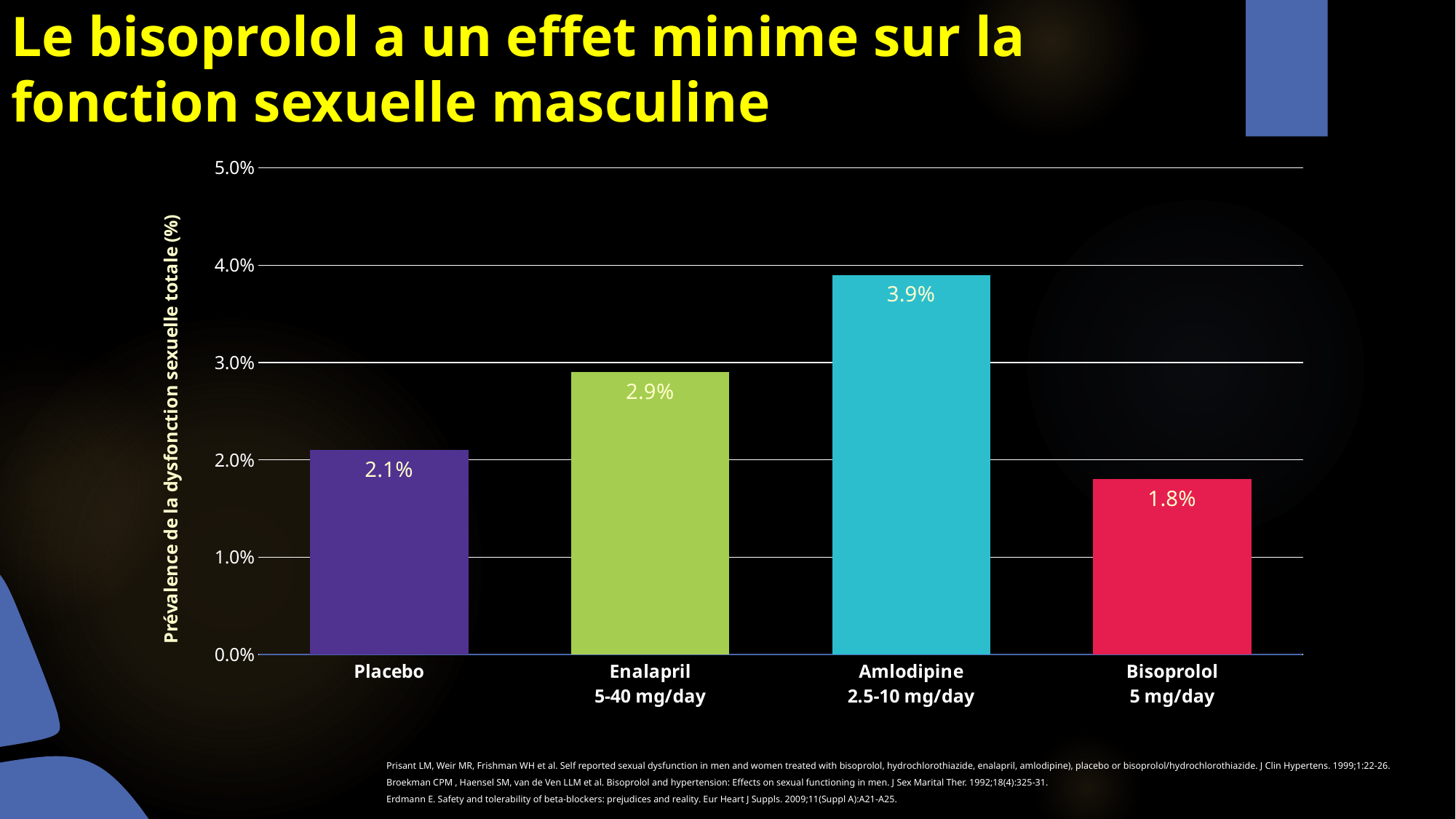
What is the difference between the values for Placebo and Bisoprolol? 0.3% Which is larger, the value for Enalapril or the value for Placebo? Enalapril What is the difference between the values for Amlodipine and Bisoprolol? 2.1% How many categories are shown on the x axis? 4 What is the value for Amlodipine 2.5-10 mg/day? 3.9% What is the value for Enalapril 5-40 mg/day? 2.9% Which category has the lowest value? Bisoprolol 5 mg/day What kind of chart is shown on the slide? Bar chart What is the label of the vertical axis? Prévalence de la dysfonction sexuelle totale (%) Which category has the highest value? Amlodipine 2.5-10 mg/day What is the value for Bisoprolol 5 mg/day? 1.8% What is the value for Placebo? 2.1%